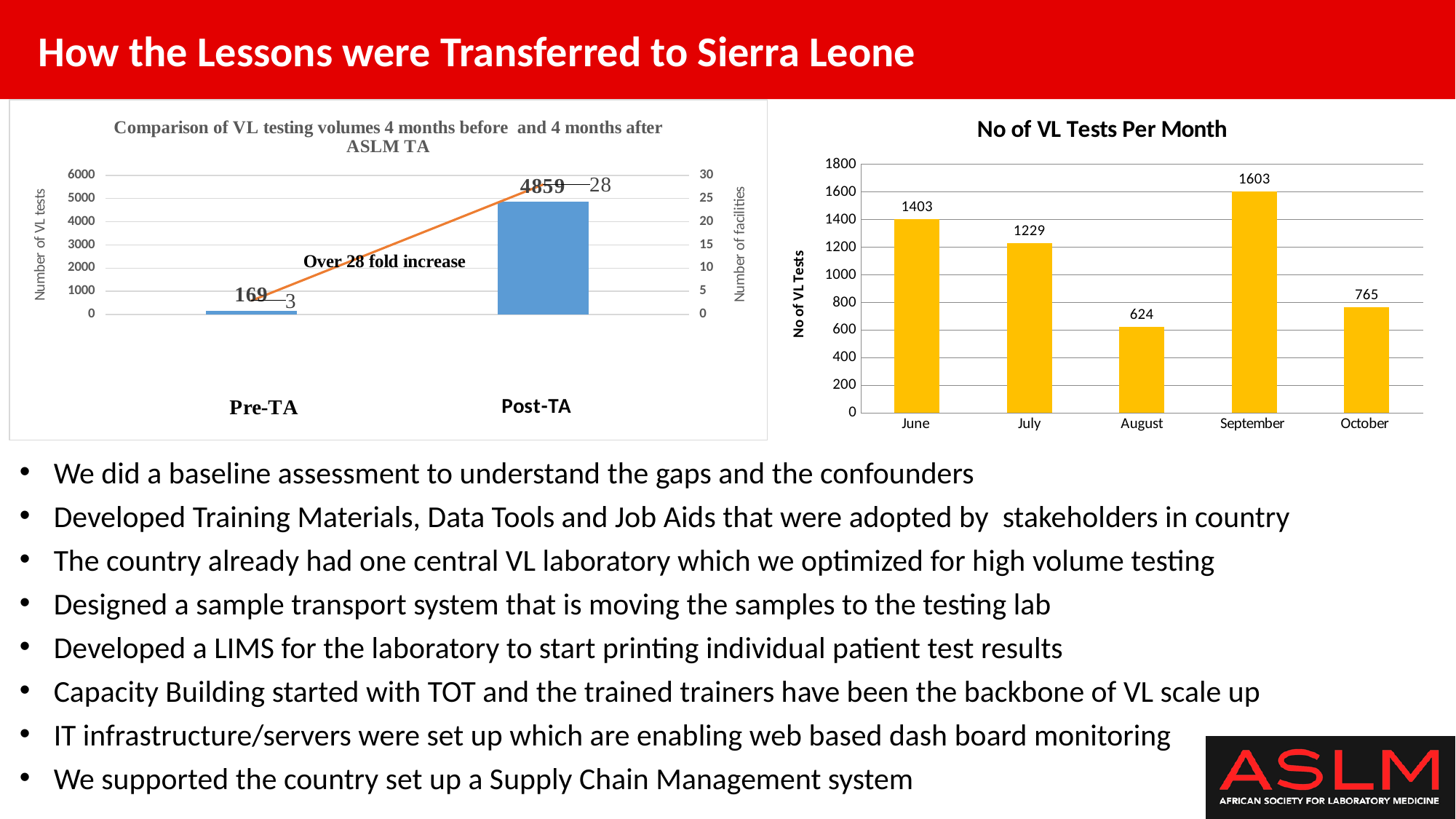
In the 'No of VL Tests Per Month' chart, which month has the lowest number of VL tests? August What kind of chart is the 'No of VL Tests Per Month' chart? Bar chart In the left chart comparing VL testing volumes before and after ASLM TA, what is the number of VL tests for Post-TA? 4859 In the left chart comparing VL testing volumes before and after ASLM TA, what is the number of facilities for Post-TA? 28 In the left chart comparing VL testing volumes before and after ASLM TA, what is the number of VL tests for Pre-TA? 169 In the 'No of VL Tests Per Month' chart, what is the difference between the values for June and July? 174 In the 'No of VL Tests Per Month' chart, what is the value for August? 624 In the 'No of VL Tests Per Month' chart, how many months are shown on the x axis? 5 In the 'No of VL Tests Per Month' chart, which is larger, the value for October or the value for August? October In the 'No of VL Tests Per Month' chart, which month has the highest number of VL tests? September In the left chart comparing VL testing volumes before and after ASLM TA, what is the difference in number of VL tests between Post-TA and Pre-TA? 4690 In the 'No of VL Tests Per Month' chart, what is the value for September? 1603